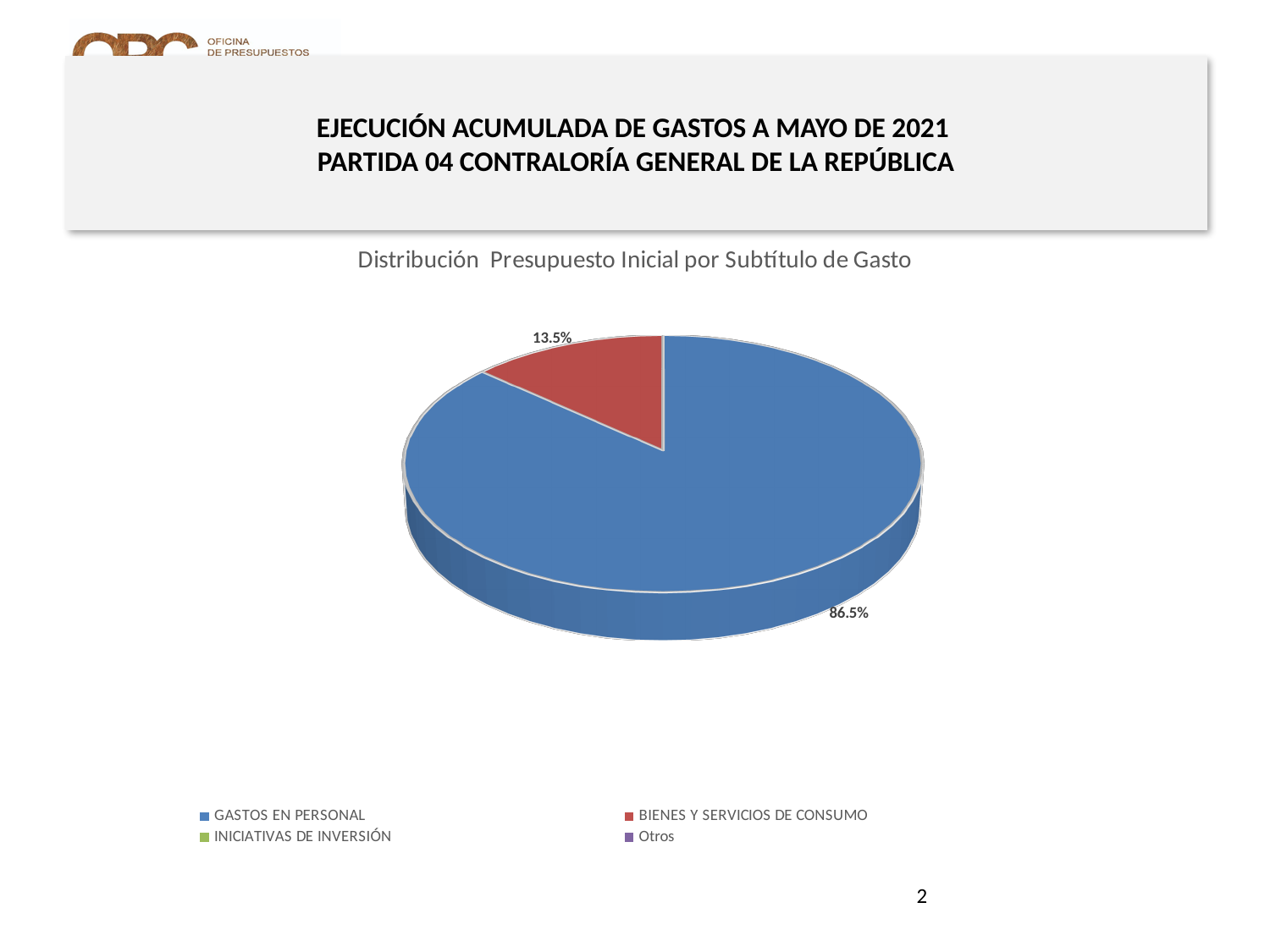
Is the share for GASTOS EN PERSONAL greater or less than 50%? greater Which of the two visible slices is smaller, GASTOS EN PERSONAL or BIENES Y SERVICIOS DE CONSUMO? BIENES Y SERVICIOS DE CONSUMO What is the difference in percentage points between the GASTOS EN PERSONAL slice and the BIENES Y SERVICIOS DE CONSUMO slice? 73.0 percentage points Is the share for BIENES Y SERVICIOS DE CONSUMO greater or less than 20%? less What share of the pie does GASTOS EN PERSONAL represent? 86.5% What kind of chart is shown on the slide? Pie chart What colour is the slice for BIENES Y SERVICIOS DE CONSUMO? Red Which is larger, the share for GASTOS EN PERSONAL or the share for BIENES Y SERVICIOS DE CONSUMO? GASTOS EN PERSONAL What share of the pie does BIENES Y SERVICIOS DE CONSUMO represent? 13.5% How many categories does the legend list? 4 Which category has the largest slice of the pie? GASTOS EN PERSONAL What is the chart's title? Distribución Presupuesto Inicial por Subtítulo de Gasto